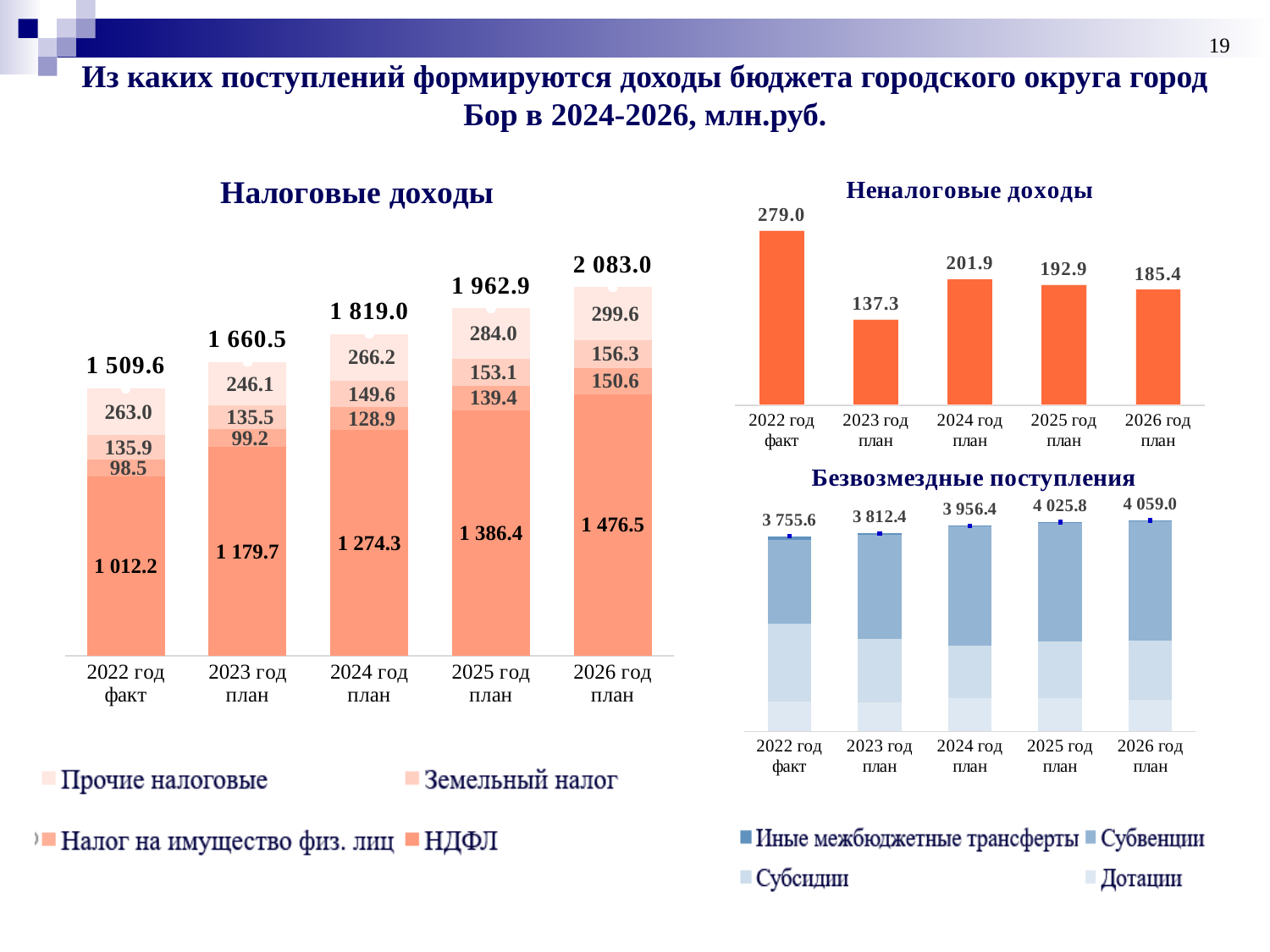
How many series does the legend of the 'Налоговые доходы' chart list? 4 In the 'Налоговые доходы' chart, by how much does the total for 2026 год план exceed the total for 2025 год план? 120.1 In the 'Неналоговые доходы' chart, which year has the lowest value? 2023 год план In the 'Неналоговые доходы' chart, what is the difference between the values for 2022 год факт and 2023 год план? 141.7 How many year categories are shown in the 'Неналоговые доходы' chart? 5 In the 'Налоговые доходы' chart, is the value of Прочие налоговые larger for 2022 год факт or 2023 год план? 2022 год факт In the 'Безвозмездные поступления' chart, do the totals rise or fall from 2022 год факт to 2026 год план? rise In the 'Неналоговые доходы' chart, which year has the highest value? 2022 год факт What kind of chart is 'Неналоговые доходы'? bar chart In the 'Налоговые доходы' chart, what is the total for 2026 год план? 2 083.0 In the 'Налоговые доходы' chart, what is the value of НДФЛ for 2024 год план? 1 274.3 In the 'Безвозмездные поступления' chart, what is the total for 2025 год план? 4 025.8